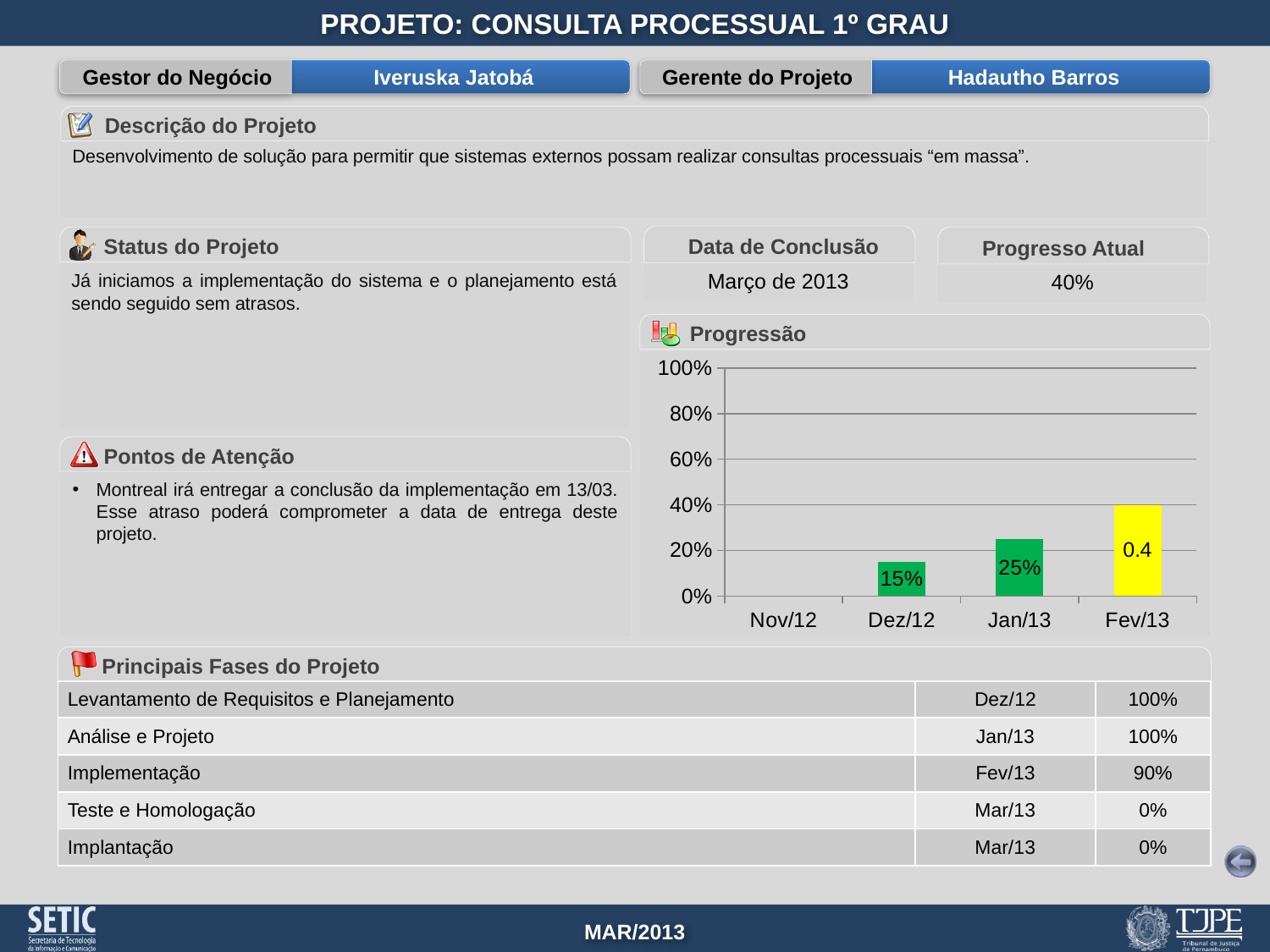
What data label is printed on the Fev/13 bar in the Progressão chart? 0.4 In the Progressão chart, which is larger: the value for Dez/12 or the value for Jan/13? Jan/13 Which month has the highest bar in the Progressão chart? Fev/13 What is the value shown for Dez/12 in the Progressão chart? 15% How many months are shown on the x axis of the Progressão chart? 4 Do the values in the Progressão chart rise or fall from Dez/12 to Fev/13? rise By how many percentage points does Jan/13 exceed Dez/12 in the Progressão chart? 10 percentage points In the Progressão chart, is the value for Fev/13 greater or less than 20%? greater What kind of chart is the Progressão chart? bar chart What is the value shown for Jan/13 in the Progressão chart? 25% What colour is the Fev/13 bar in the Progressão chart? yellow